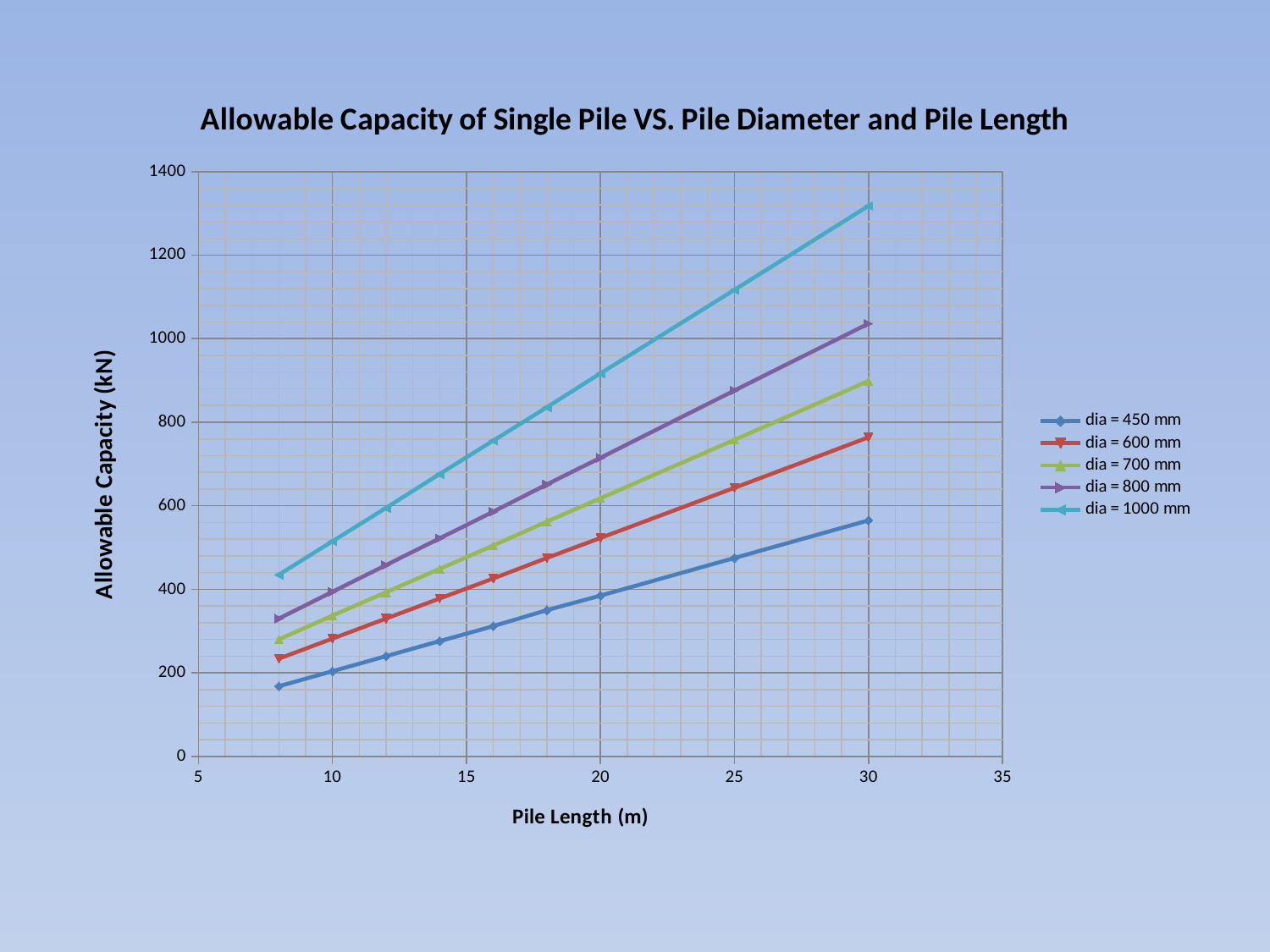
Which series has the lowest allowable capacity at a pile length of 30 m? dia = 450 mm What is the title of the chart? Allowable Capacity of Single Pile VS. Pile Diameter and Pile Length Is the allowable capacity for dia = 450 mm at a pile length of 8 m greater or less than 200? less At a pile length of 20 m, which is larger: the allowable capacity for dia = 800 mm or for dia = 600 mm? dia = 800 mm What kind of chart is shown on the slide? line chart What is the label of the vertical axis? Allowable Capacity (kN) How many data points are plotted for the dia = 450 mm series? 9 How many series does the legend list? 5 Does the allowable capacity for dia = 1000 mm rise or fall as pile length increases? rise Is the allowable capacity for dia = 1000 mm at a pile length of 30 m greater or less than 1200? greater Which series has the highest allowable capacity at a pile length of 30 m? dia = 1000 mm Is the allowable capacity for dia = 450 mm at a pile length of 30 m greater or less than 600? less